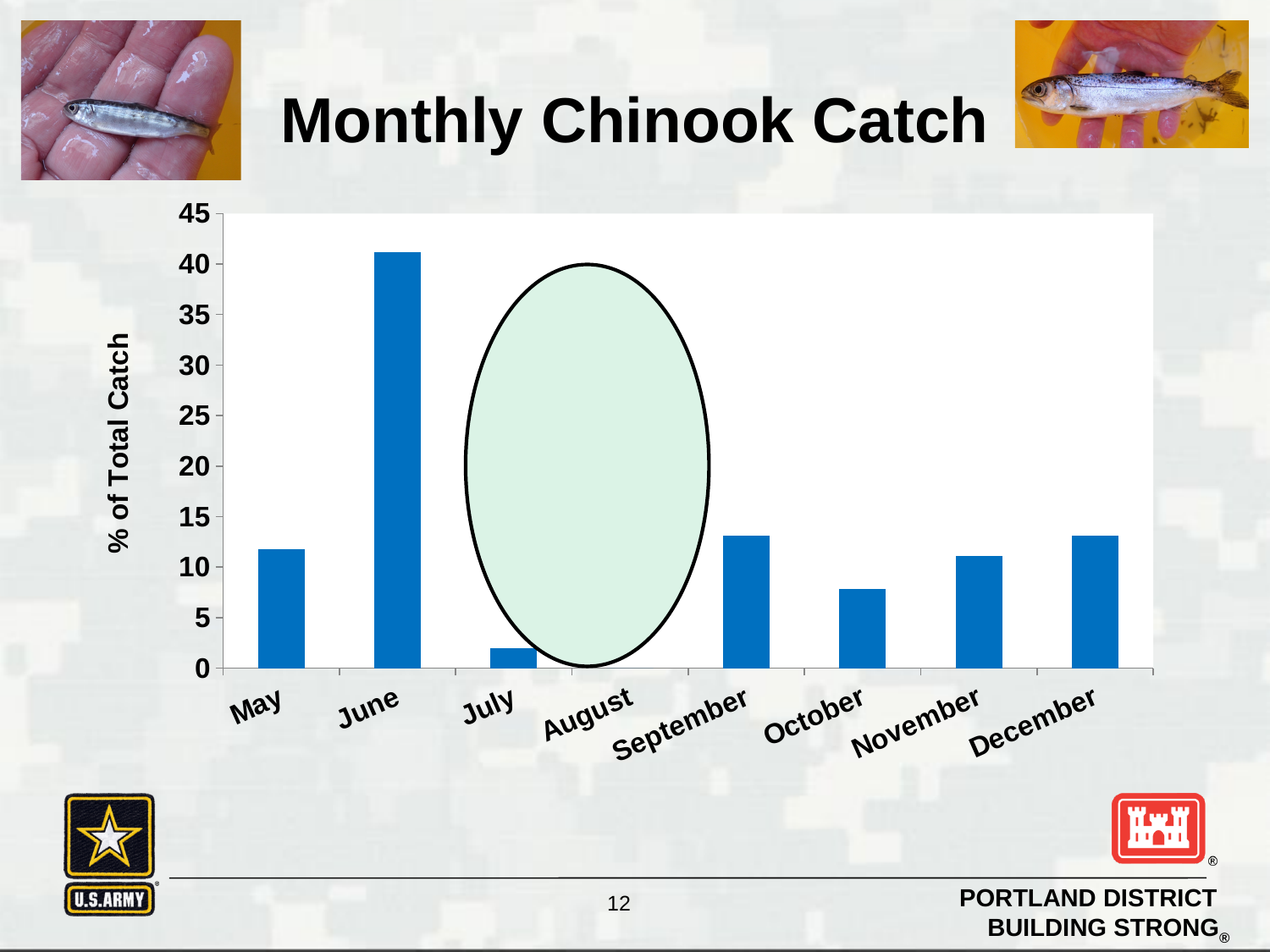
What is the label on the y axis of the chart? % of Total Catch Is the value for May greater or less than 15? less Which has a larger % of total catch, May or June? June Which month has the highest % of total catch? June What is the title of the chart? Monthly Chinook Catch Is the value for October greater or less than 10? less How many months are shown on the x axis of the chart? 8 Is the value for September greater or less than 10? greater What kind of chart is shown on the slide? bar chart Which has a larger % of total catch, September or October? September